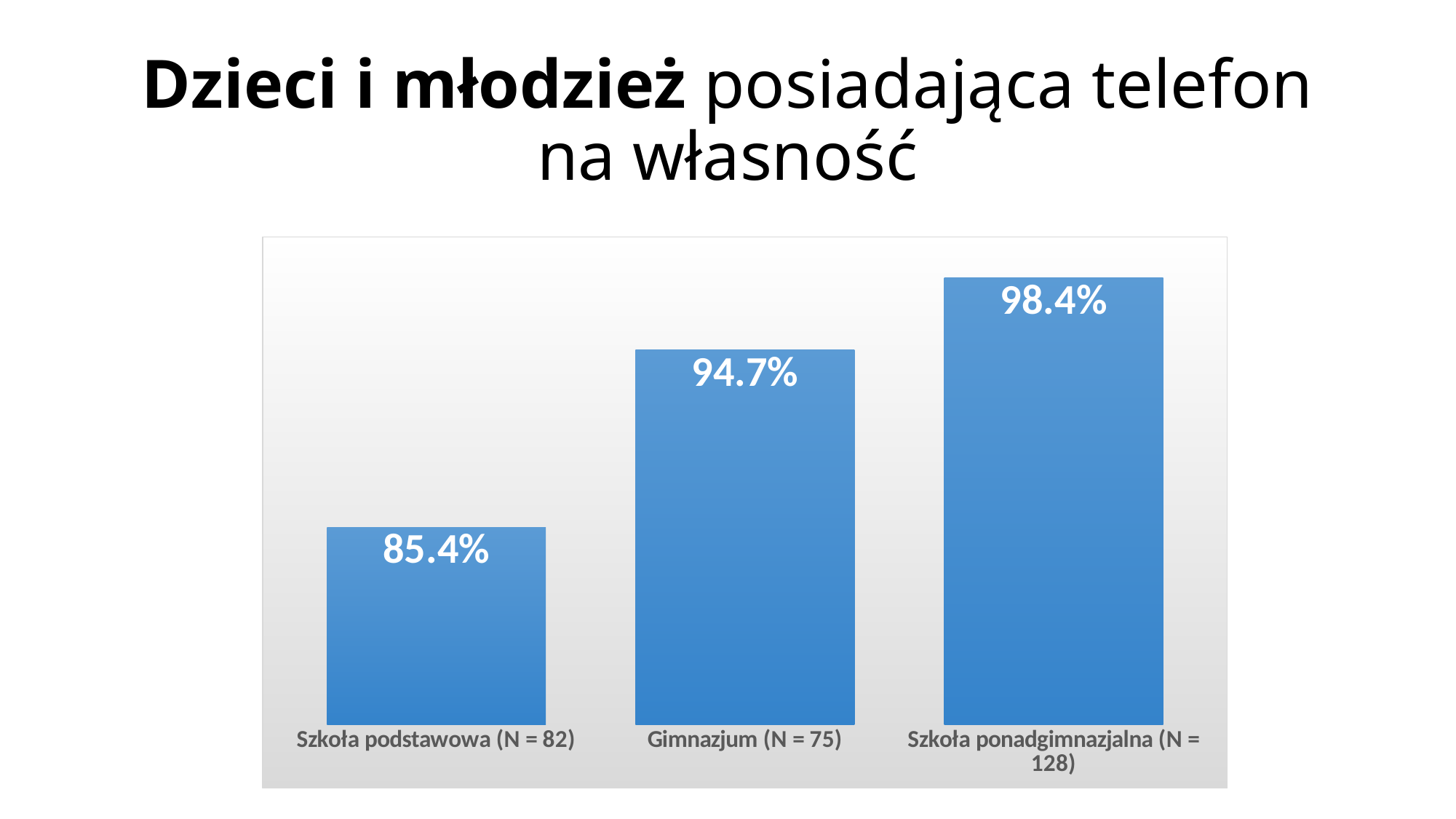
What is the value for Szkoła podstawowa (N = 82)? 85.4% Do the values rise or fall from left to right across the categories? Rise What is the difference between the values for Gimnazjum and Szkoła podstawowa? 9.3% Which is larger, the value for Gimnazjum or the value for Szkoła podstawowa? Gimnazjum What kind of chart is shown on the slide? Bar chart What is the difference between the values for Szkoła ponadgimnazjalna and Szkoła podstawowa? 13.0% What is the value for Szkoła ponadgimnazjalna (N = 128)? 98.4% Which category has the highest value? Szkoła ponadgimnazjalna (N = 128) What is the value for Gimnazjum (N = 75)? 94.7% Which category has the lowest value? Szkoła podstawowa (N = 82) How many categories are shown in the chart? 3 What is the title of the slide? Dzieci i młodzież posiadająca telefon na własność